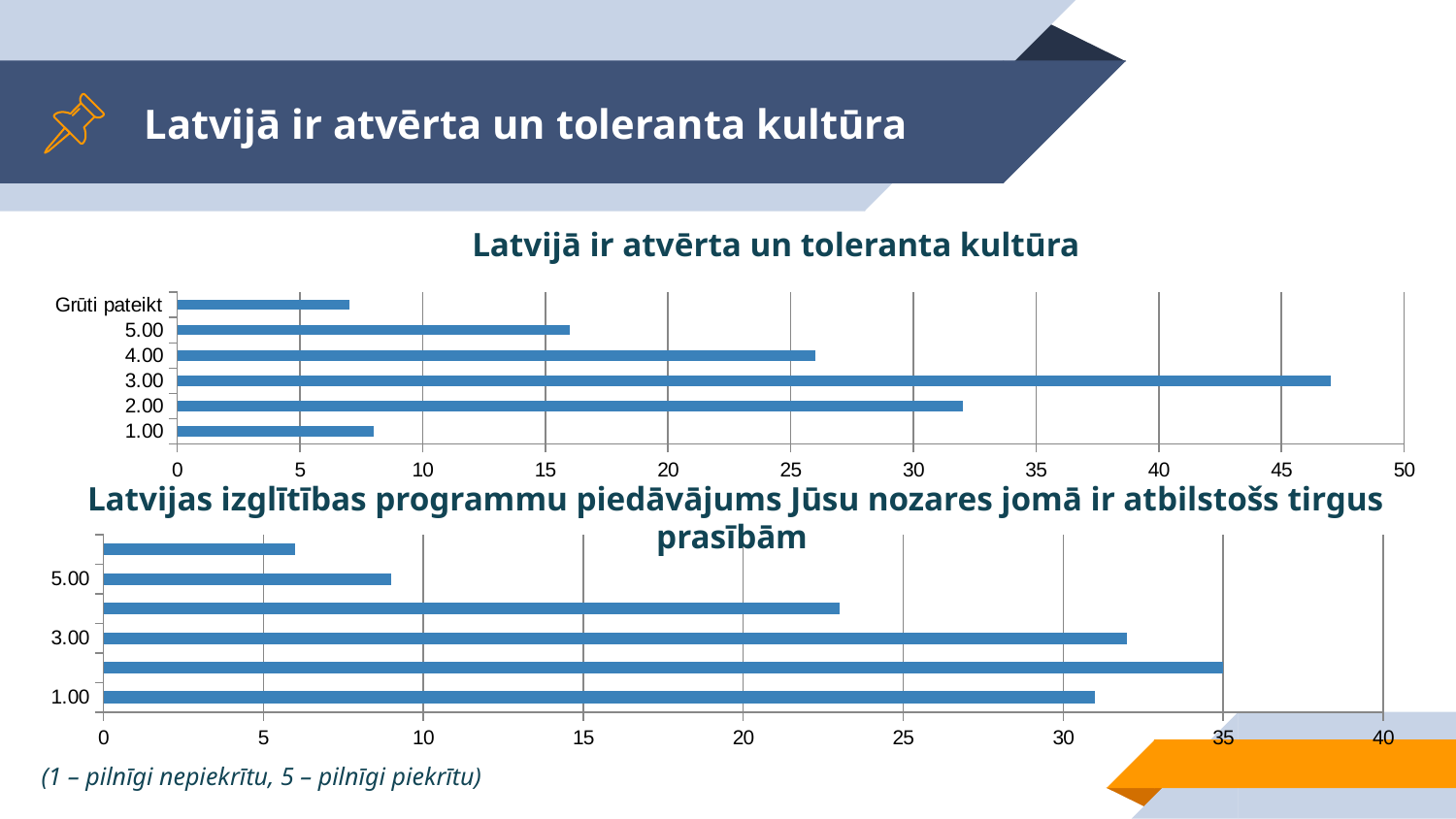
How many categories are shown in the top chart 'Latvijā ir atvērta un toleranta kultūra'? 6 In the top chart 'Latvijā ir atvērta un toleranta kultūra', which category has the longest bar? 3.00 In the top chart 'Latvijā ir atvērta un toleranta kultūra', which category has the shortest bar? Grūti pateikt In the top chart 'Latvijā ir atvērta un toleranta kultūra', is the value for 2.00 greater or less than 30? greater In the bottom chart 'Latvijas izglītības programmu piedāvājums...', which is larger, the value for 5.00 or the value for 3.00? 3.00 What kind of chart is the top chart 'Latvijā ir atvērta un toleranta kultūra'? bar chart In the bottom chart 'Latvijas izglītības programmu piedāvājums...', is the value for 3.00 greater or less than 30? greater In the bottom chart 'Latvijas izglītības programmu piedāvājums...', is the value for 5.00 greater or less than 10? less What is the maximum value shown on the x axis of the bottom chart 'Latvijas izglītības programmu piedāvājums...'? 40 In the top chart 'Latvijā ir atvērta un toleranta kultūra', which is larger, the value for 4.00 or the value for 2.00? 2.00